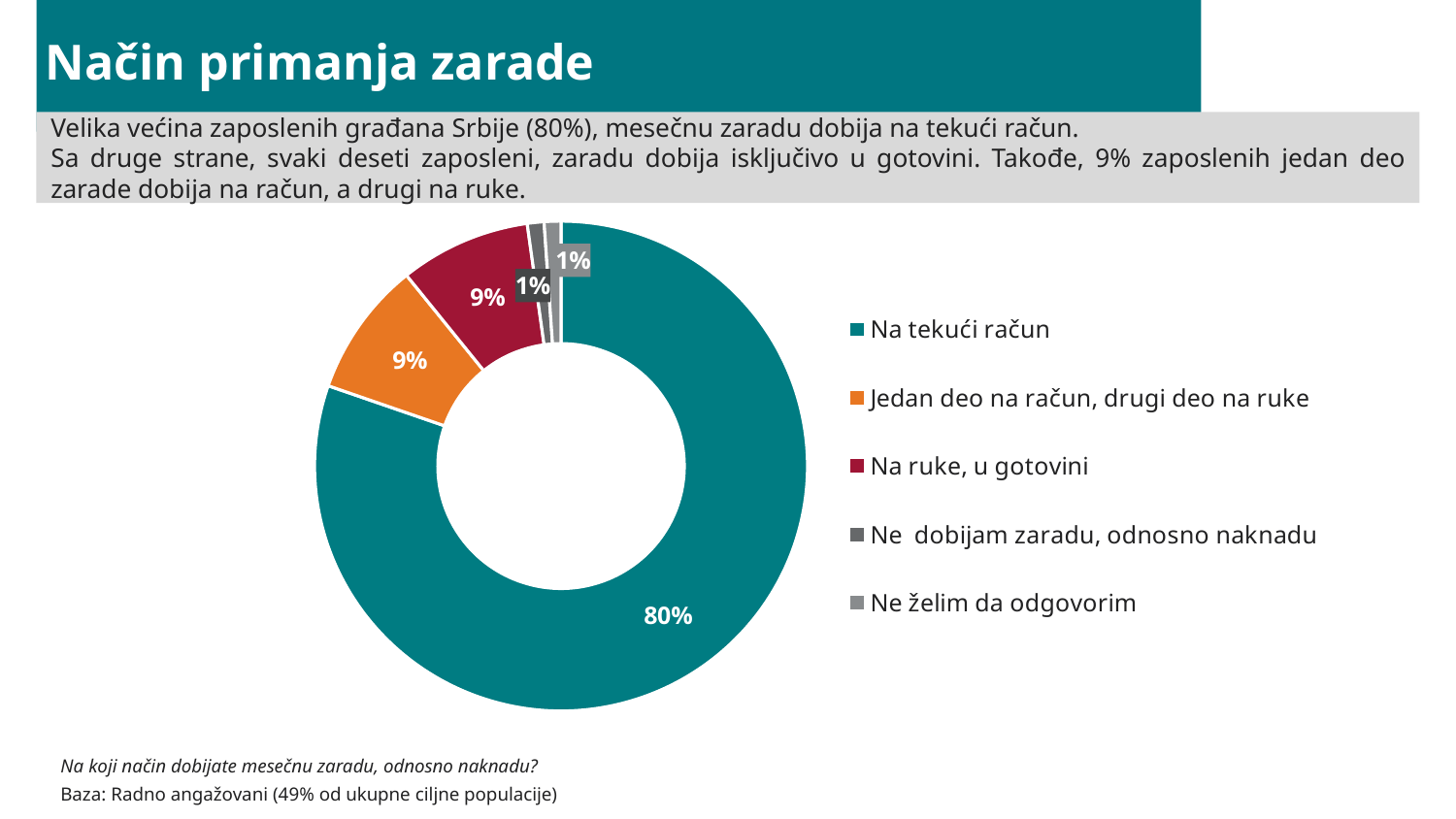
Which category has the largest share in the chart? Na tekući račun What is the difference in percentage points between 'Na tekući račun' and 'Na ruke, u gotovini'? 71 What is the value for 'Na ruke, u gotovini'? 9% What share of the chart does 'Na tekući račun' take up? 80% What colour represents 'Na ruke, u gotovini' in the chart? Dark red How many categories does the chart show? 5 What percentage of respondents receive their salary 'Na tekući račun'? 80% What is the value for 'Ne želim da odgovorim'? 1% What kind of chart is shown on the slide? Doughnut (pie) chart What is the value for 'Jedan deo na račun, drugi deo na ruke'? 9% Which is larger: 'Na tekući račun' or 'Jedan deo na račun, drugi deo na ruke'? Na tekući račun What is the value for 'Ne dobijam zaradu, odnosno naknadu'? 1%